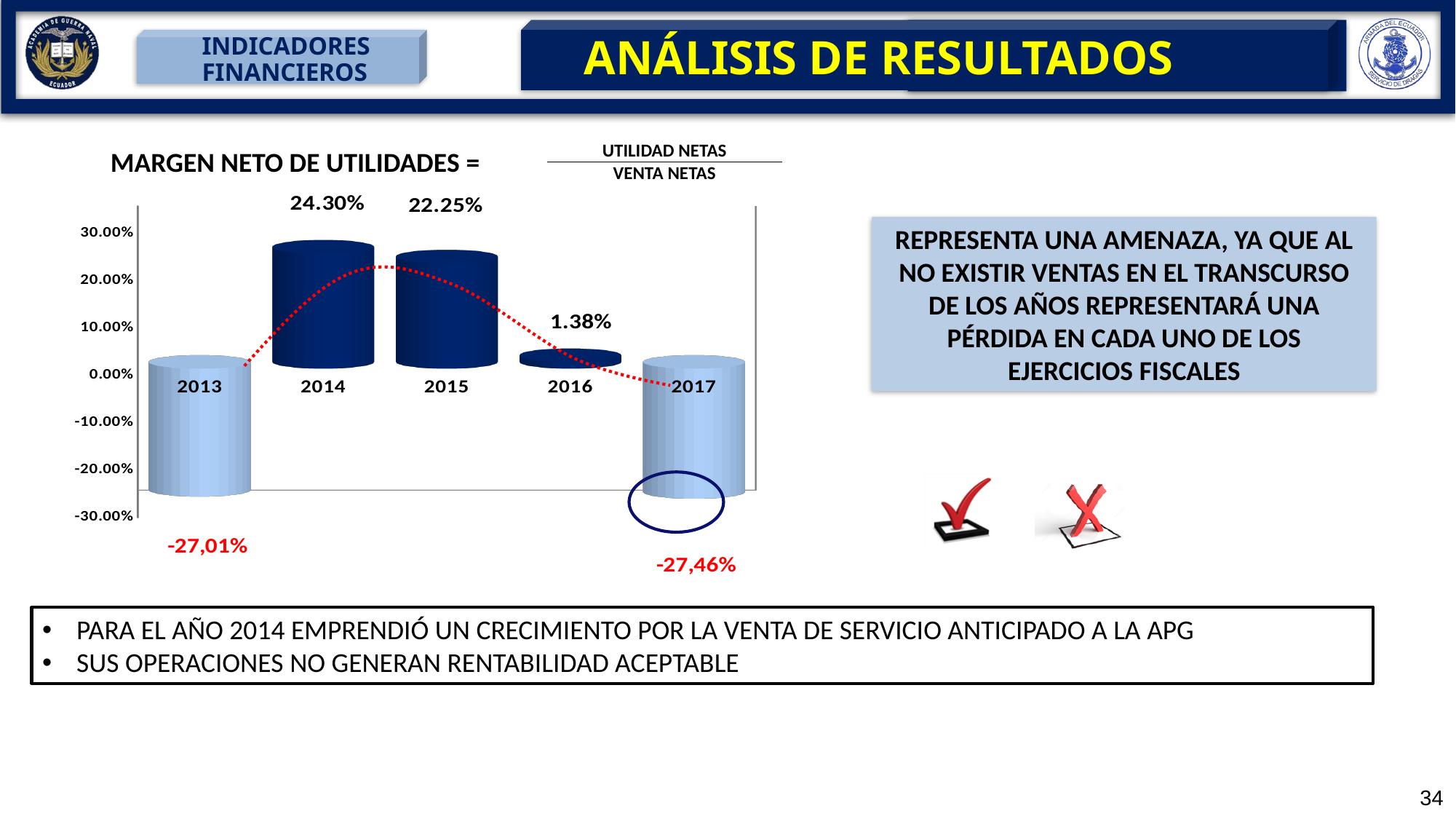
Which is larger, the value for 2014 or the value for 2015? 2014 How many years are plotted in the chart? 5 Which year has the highest net profit margin in the chart? 2014 What value is printed for 2013 in the chart? -27,01% What kind of chart is used to show the net profit margin? Bar chart What is the difference between the values for 2015 and 2016? 20.87% What value is printed for 2017 in the chart? -27,46% What is the net profit margin (margen neto de utilidades) shown for 2014? 24.30% What value is shown for 2016 in the chart? 1.38% Do the values rise or fall from 2014 to 2017? Fall What is the difference between the values for 2014 and 2015? 2.05% What value is shown for 2015 in the chart? 22.25%